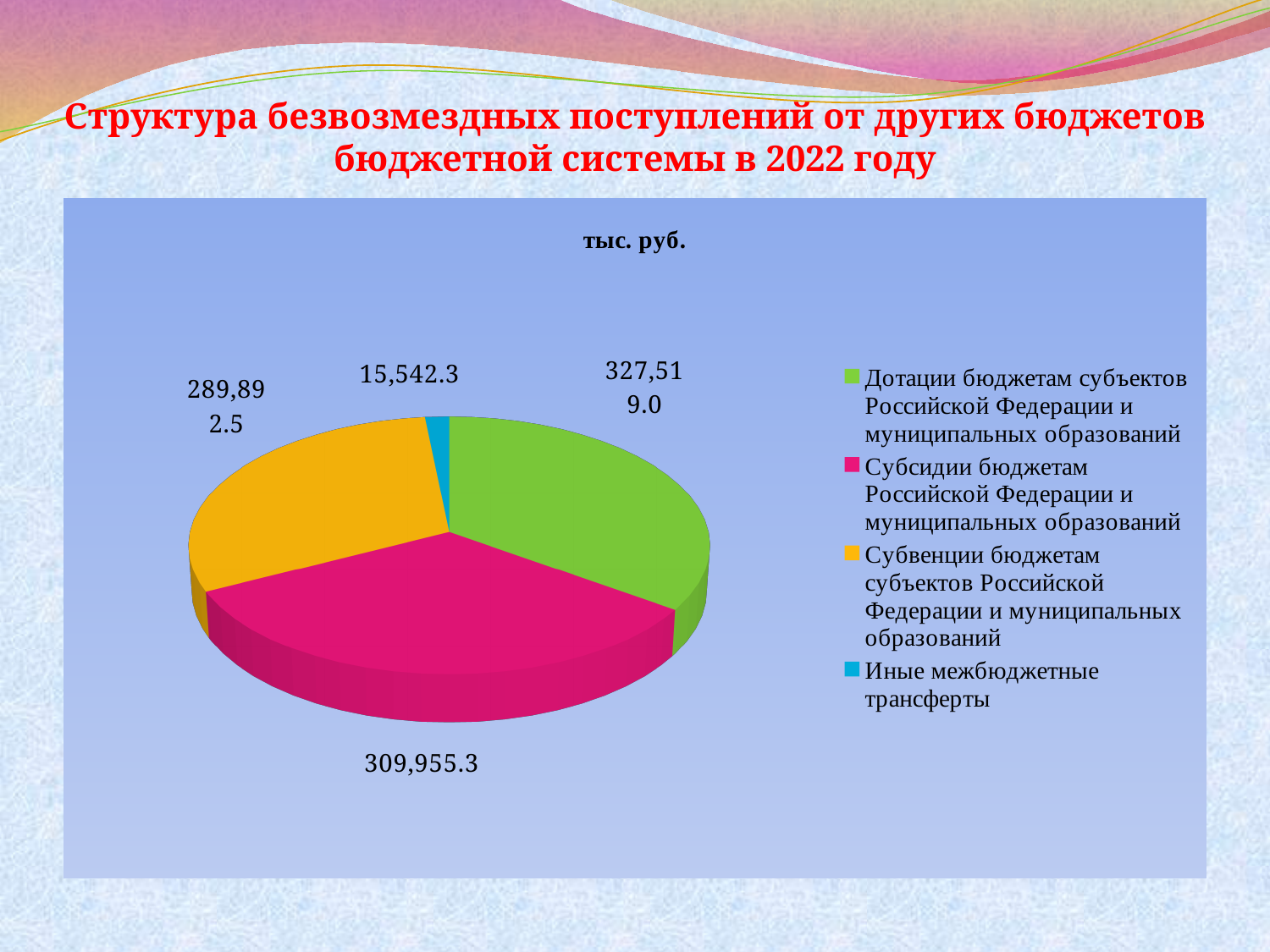
What is the value for Иные межбюджетные трансферты? 15,542.3 What is the value for Дотации бюджетам субъектов Российской Федерации и муниципальных образований? 327,519.0 What is the difference between the value for Дотации (327,519.0) and the value for Субсидии (309,955.3)? 17,563.7 Which category has the smallest slice of the pie? Иные межбюджетные трансферты What is the value for Субвенции бюджетам субъектов Российской Федерации и муниципальных образований? 289,892.5 Which is larger: the value for Субсидии or the value for Субвенции? Субсидии What is the value for Субсидии бюджетам Российской Федерации и муниципальных образований? 309,955.3 How many entries does the legend list? 4 Which category has the largest value in the pie chart? Дотации бюджетам субъектов Российской Федерации и муниципальных образований How many slices does the pie chart have? 4 What type of chart is shown on the slide? Pie chart What unit is given in the chart title above the pie? тыс. руб.